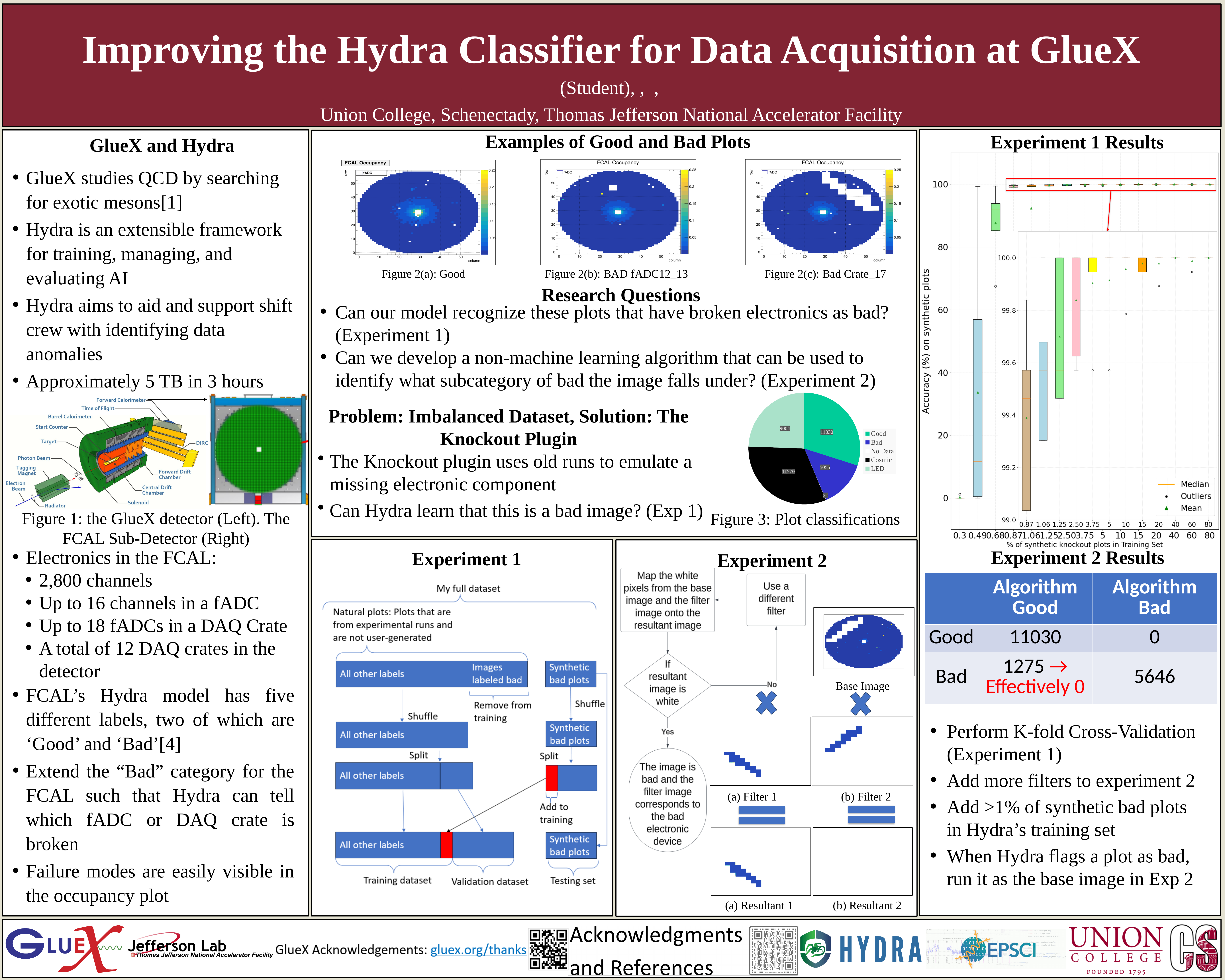
How many categories does the legend of the Figure 3 pie chart list? 5 In the Figure 3 pie chart, what is the difference between the Cosmic and Good values? 740 What kind of chart is Figure 3: Plot classifications? Pie chart In the Experiment 1 Results chart, is the median accuracy at 0.3% synthetic knockout plots greater or less than 20? less In the Figure 3 pie chart, which is larger, Good or LED? Good In the Figure 3 pie chart, what is the value for LED? 9004 In the Figure 3 pie chart, what is the value for Cosmic? 11770 In the Figure 3 pie chart, what is the difference between the Good and Bad values? 5975 In the Figure 3 pie chart, what is the value for Good? 11030 In the Figure 3 pie chart, which category has the largest value? Cosmic In the Experiment 1 Results chart, what is the y-axis label? Accuracy (%) on synthetic plots In the Figure 3 pie chart, what is the value for Bad? 5055